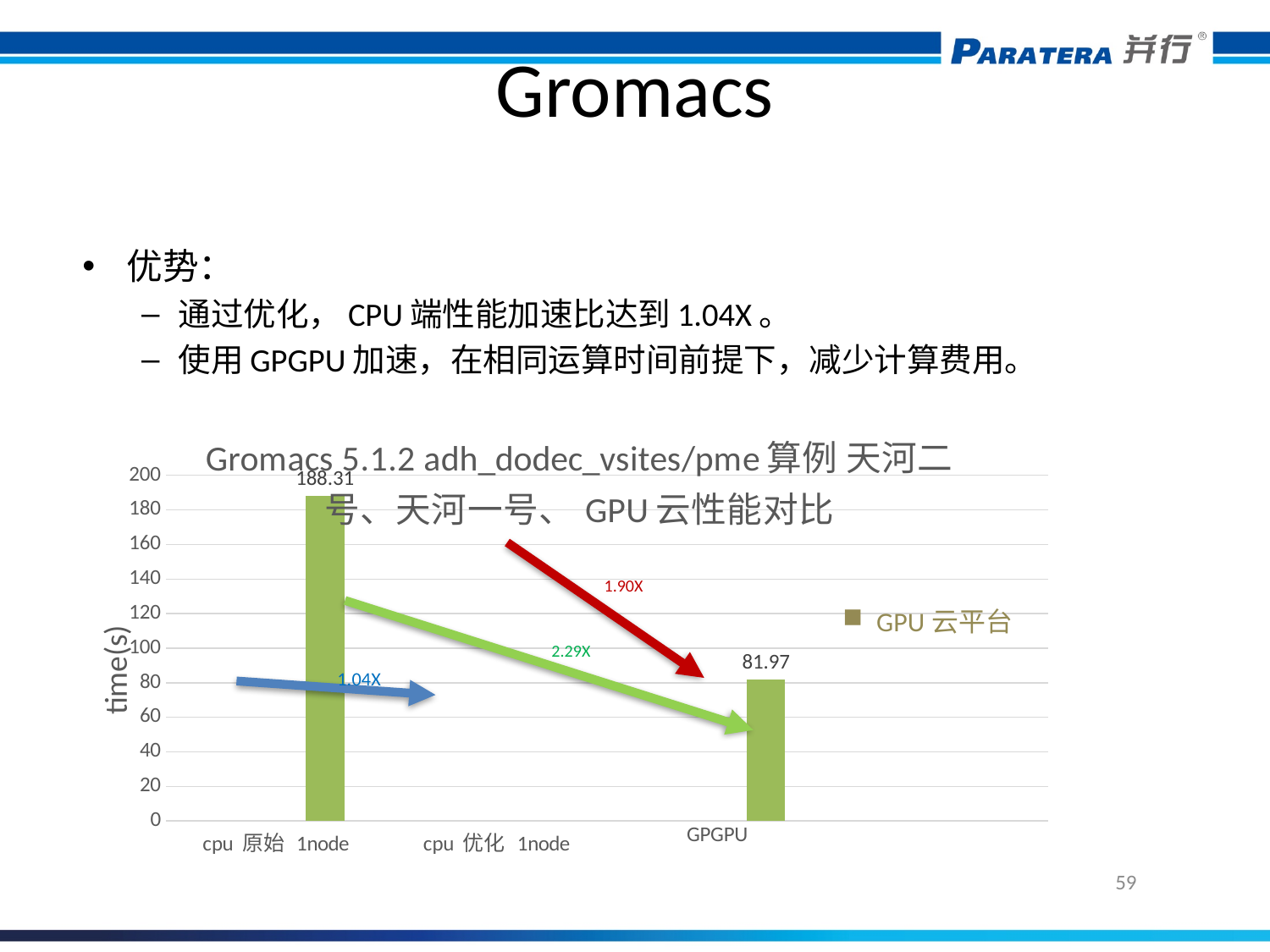
What kind of chart is shown on the slide? bar chart How many categories are labelled on the x axis? 3 Is the value for GPGPU greater or less than 100? less What is the value for GPGPU? 81.97 What is the difference between the values for cpu 原始 1node and GPGPU? 106.34 Is the value for cpu 原始 1node greater or less than 160? greater Which is larger, the value for cpu 原始 1node or the value for GPGPU? cpu 原始 1node What series name appears in the legend? GPU 云平台 What is the value for cpu 原始 1node? 188.31 Which category has the tallest bar? cpu 原始 1node What is the label of the y axis? time(s) How many series does the legend list? 1